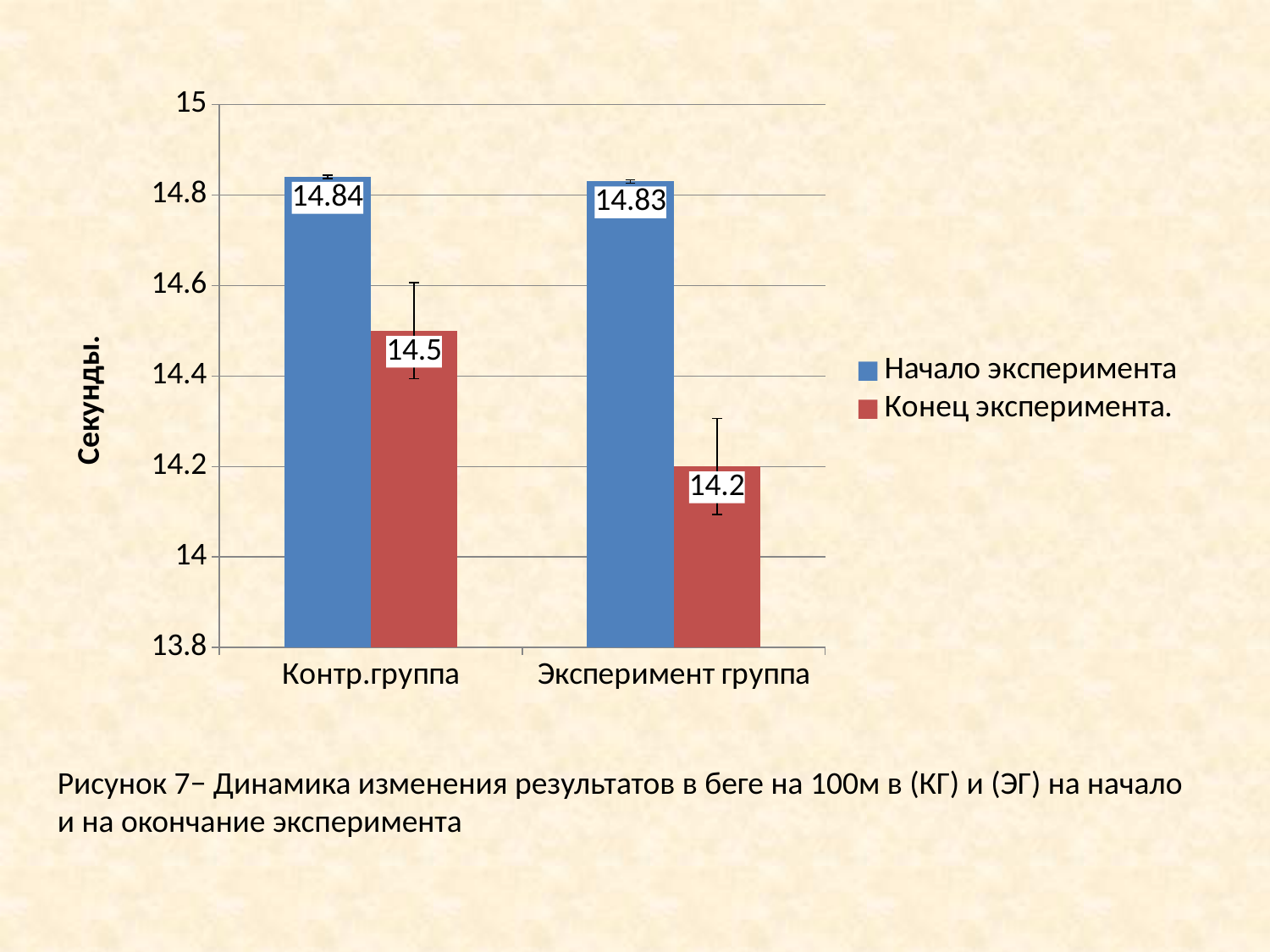
Which is larger: the Конец эксперимента. value for Контр.группа or for Эксперимент группа? Контр.группа Is the Конец эксперимента. value for Эксперимент группа greater or less than 14.4? less What is the difference between the Начало эксперимента and Конец эксперимента. values for Контр.группа? 0.34 What is the value for Эксперимент группа in the Начало эксперимента series? 14.83 Which category has the lowest value in the Конец эксперимента. series? Эксперимент группа What is the difference between the Начало эксперимента and Конец эксперимента. values for Эксперимент группа? 0.63 What is the value for Контр.группа in the Начало эксперимента series? 14.84 How many series does the legend list? 2 What is the value for Контр.группа in the Конец эксперимента. series? 14.5 How many categories are shown on the x axis? 2 What kind of chart is shown on the slide? bar chart What is the value for Эксперимент группа in the Конец эксперимента. series? 14.2